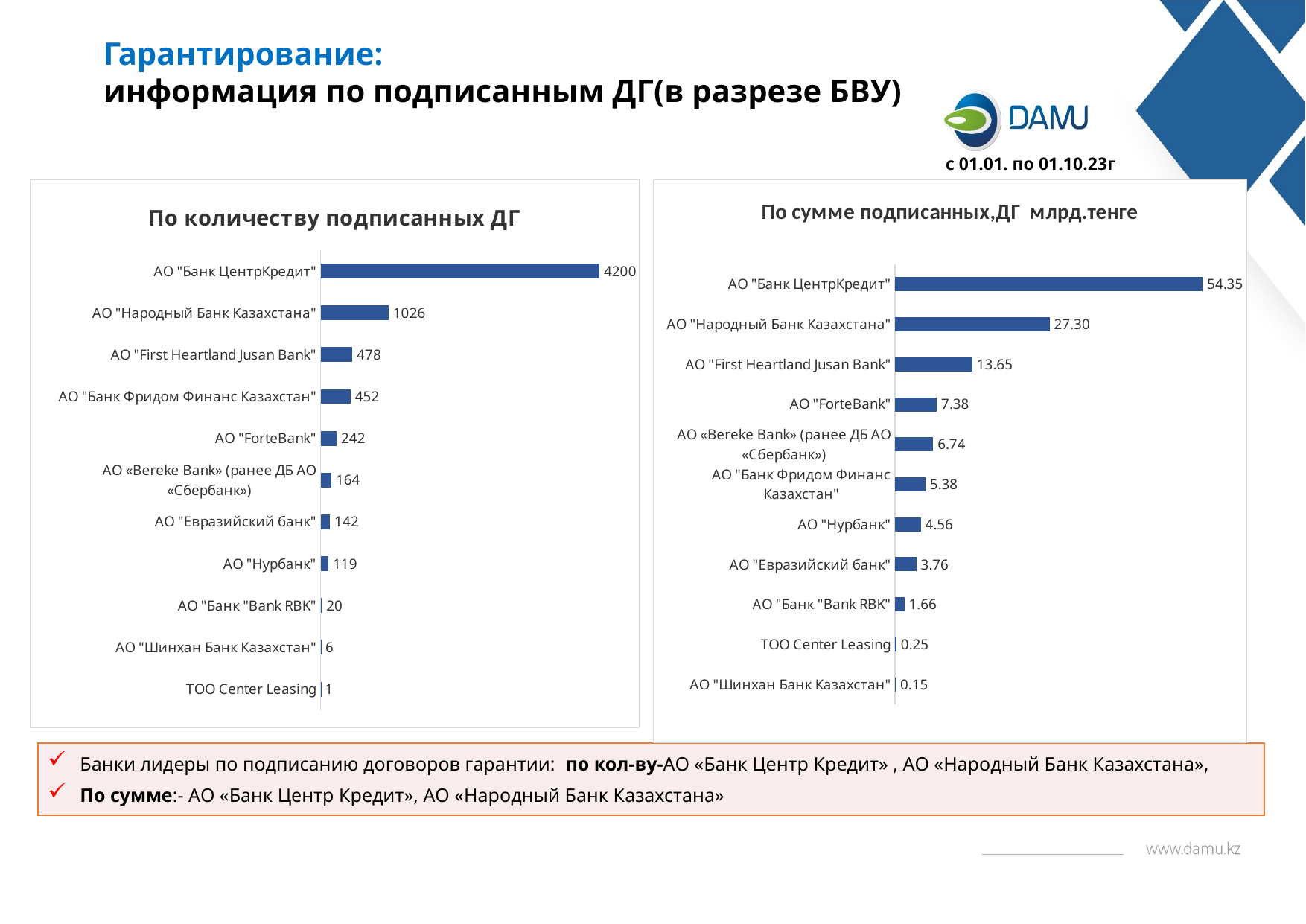
In the chart "По количеству подписанных ДГ", which bank has the highest value? АО "Банк ЦентрКредит" In the chart "По сумме подписанных,ДГ млрд.тенге", which category has the lowest value? АО "Шинхан Банк Казахстан" In the chart "По сумме подписанных,ДГ млрд.тенге", what is the difference between АО "Банк ЦентрКредит" and АО "Народный Банк Казахстана"? 27.05 In the chart "По сумме подписанных,ДГ млрд.тенге", what is the value for АО "ForteBank"? 7.38 In the chart "По сумме подписанных,ДГ млрд.тенге", what is the value for ТОО Center Leasing? 0.25 In the chart "По количеству подписанных ДГ", what is the difference between АО "First Heartland Jusan Bank" and АО "Банк Фридом Финанс Казахстан"? 26 What type of chart is "По сумме подписанных,ДГ млрд.тенге"? Bar chart In the chart "По количеству подписанных ДГ", which is larger: АО "Евразийский банк" or АО "Нурбанк"? АО "Евразийский банк" In the chart "По количеству подписанных ДГ", what is the value for АО "Народный Банк Казахстана"? 1026 In the chart "По количеству подписанных ДГ", which category has the lowest value? ТОО Center Leasing In the chart "По количеству подписанных ДГ", how many categories are shown? 11 In the chart "По сумме подписанных,ДГ млрд.тенге", which is larger: АО "Нурбанк" or АО "Евразийский банк"? АО "Нурбанк"